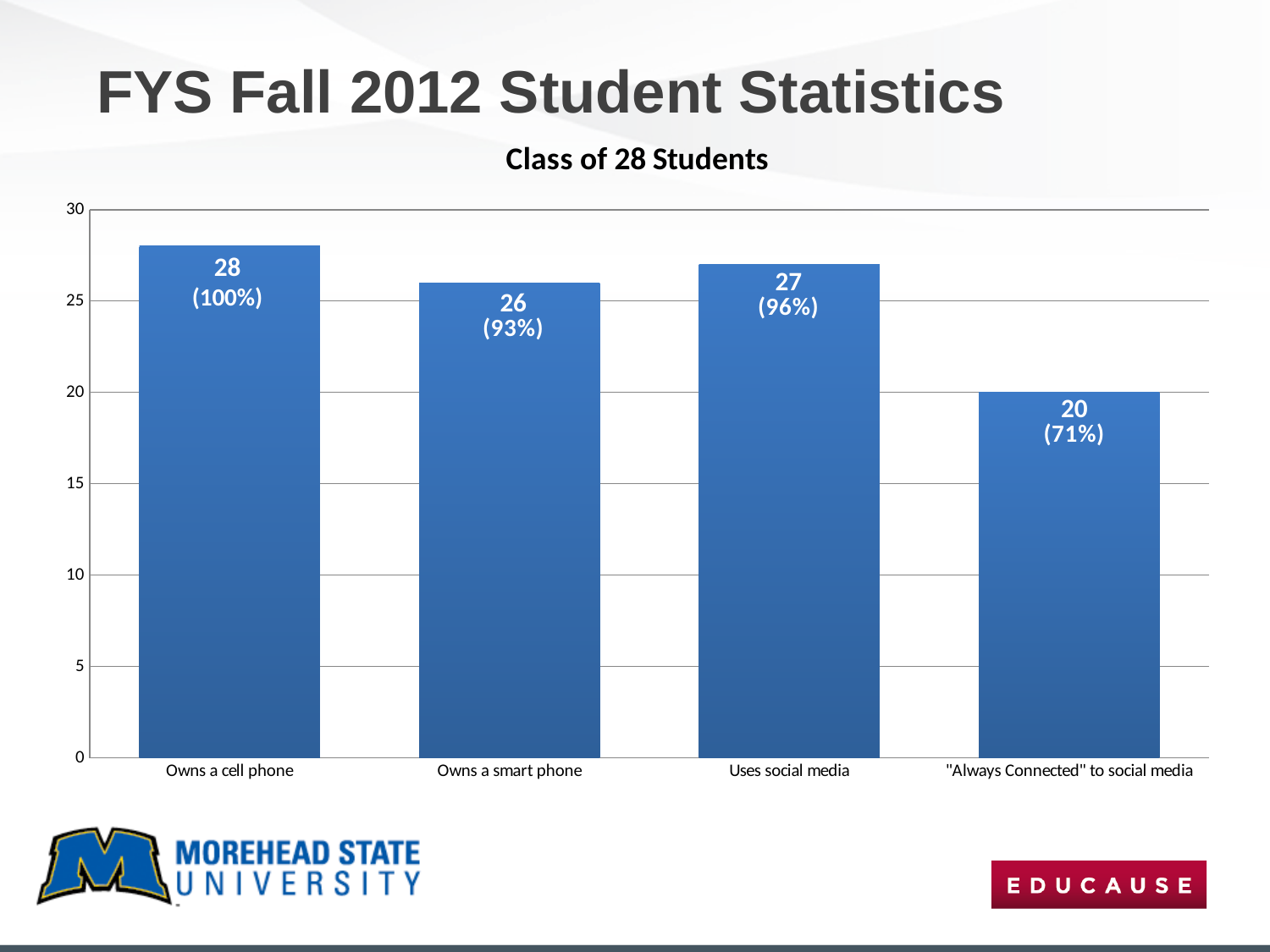
Is the value for "Always Connected" to social media greater or less than 25? less Which category has the lowest value? "Always Connected" to social media Which category has the highest value? Owns a cell phone How many categories are shown on the chart? 4 What kind of chart is shown on the slide? Bar chart What is the difference between the number of students who own a cell phone and the number who are "Always Connected" to social media? 8 How many students own a cell phone? 28 What percentage of students uses social media? 96% What is the title of the chart? Class of 28 Students Which is larger: the number of students who own a smart phone or the number who use social media? Uses social media How many students own a smart phone? 26 How many students are "Always Connected" to social media? 20